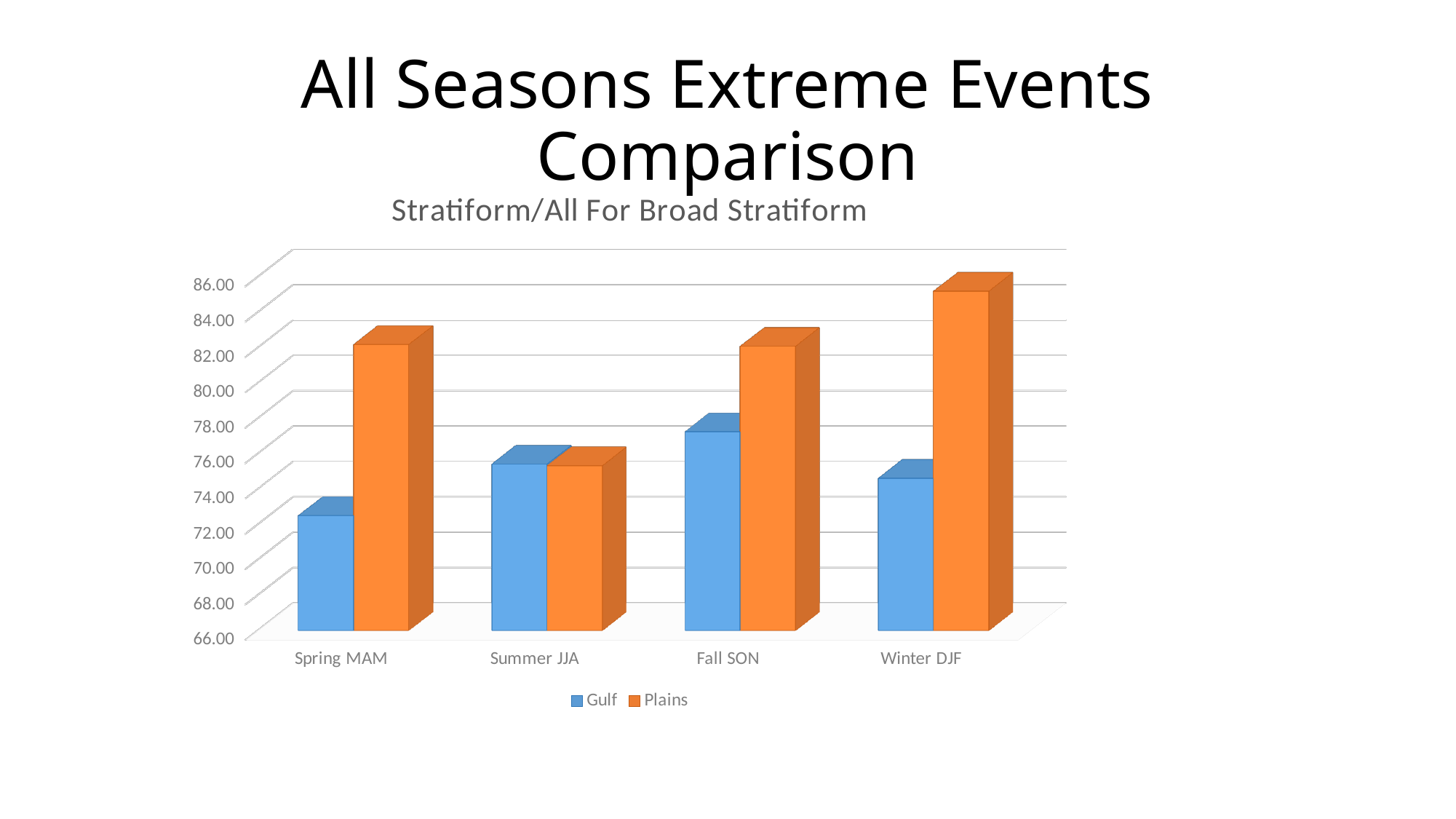
Which season has the highest Gulf value? Fall SON Is the Gulf value for Spring MAM greater or less than 74.00? less Which season has the highest Plains value? Winter DJF What is the title of the chart? Stratiform/All For Broad Stratiform Which season has the lowest Gulf value? Spring MAM Is the Gulf value for Fall SON greater or less than 76.00? greater Which season has the lowest Plains value? Summer JJA How many seasons (categories) are shown on the x axis? 4 Is the Plains value for Winter DJF greater or less than 84.00? greater What kind of chart is shown on the slide? Bar chart For Spring MAM, which series has the larger value, Gulf or Plains? Plains How many series does the legend list? 2